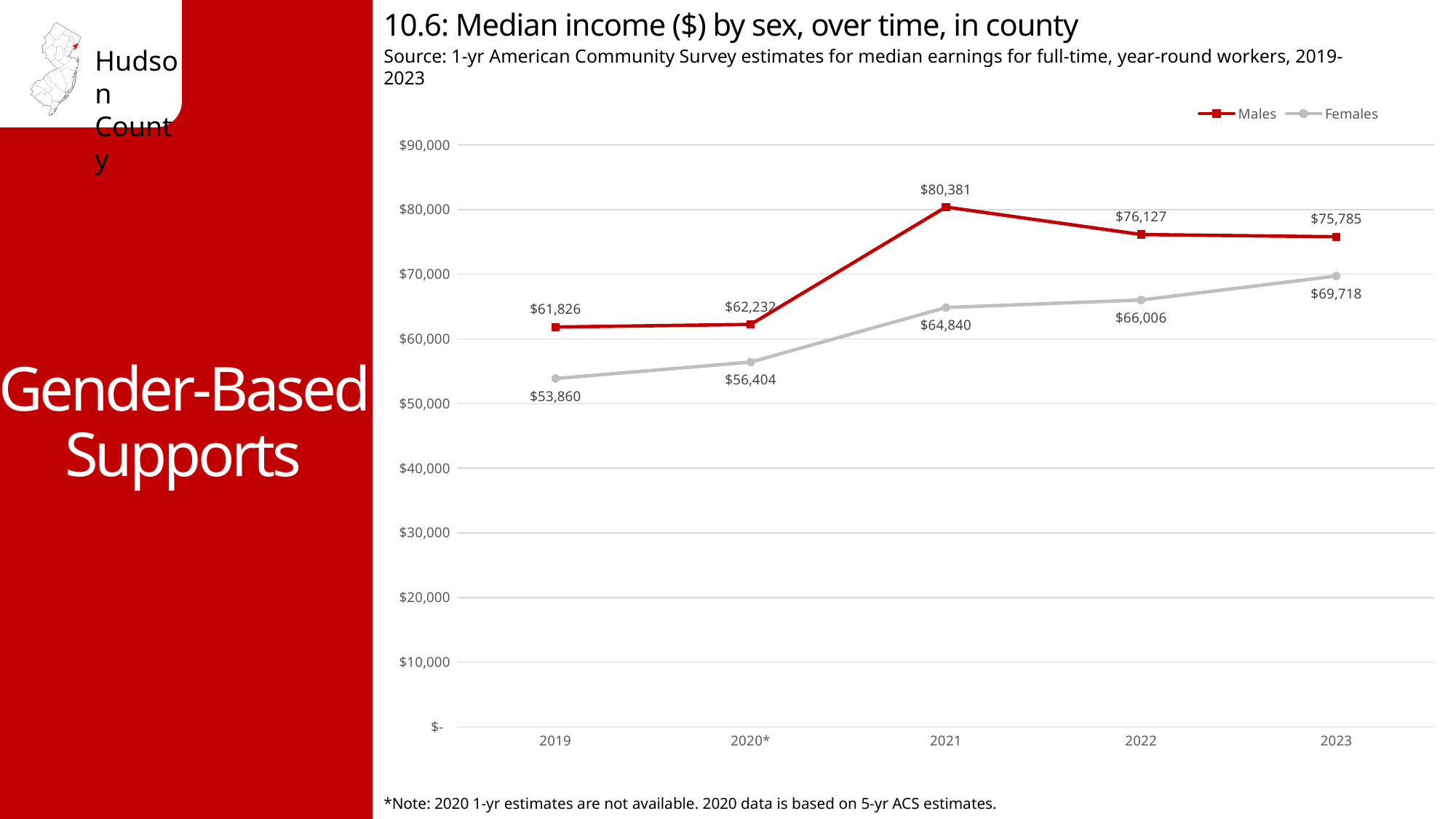
Does the Females median income rise or fall from 2019 to 2023? Rise What is the median income for Females in 2019? $53,860 What kind of chart is shown on the slide? Line chart Is the Females median income in 2021 greater or less than $60,000? greater In which year is the Males median income highest? 2021 What is the difference between the Males and Females median income in 2022? $10,121 What is the median income for Females in 2023? $69,718 How many series does the legend list? 2 In which year is the Females median income lowest? 2019 What is the median income for Males in 2021? $80,381 Which series has the higher median income in 2020*, Males or Females? Males How many years are shown on the x axis? 5